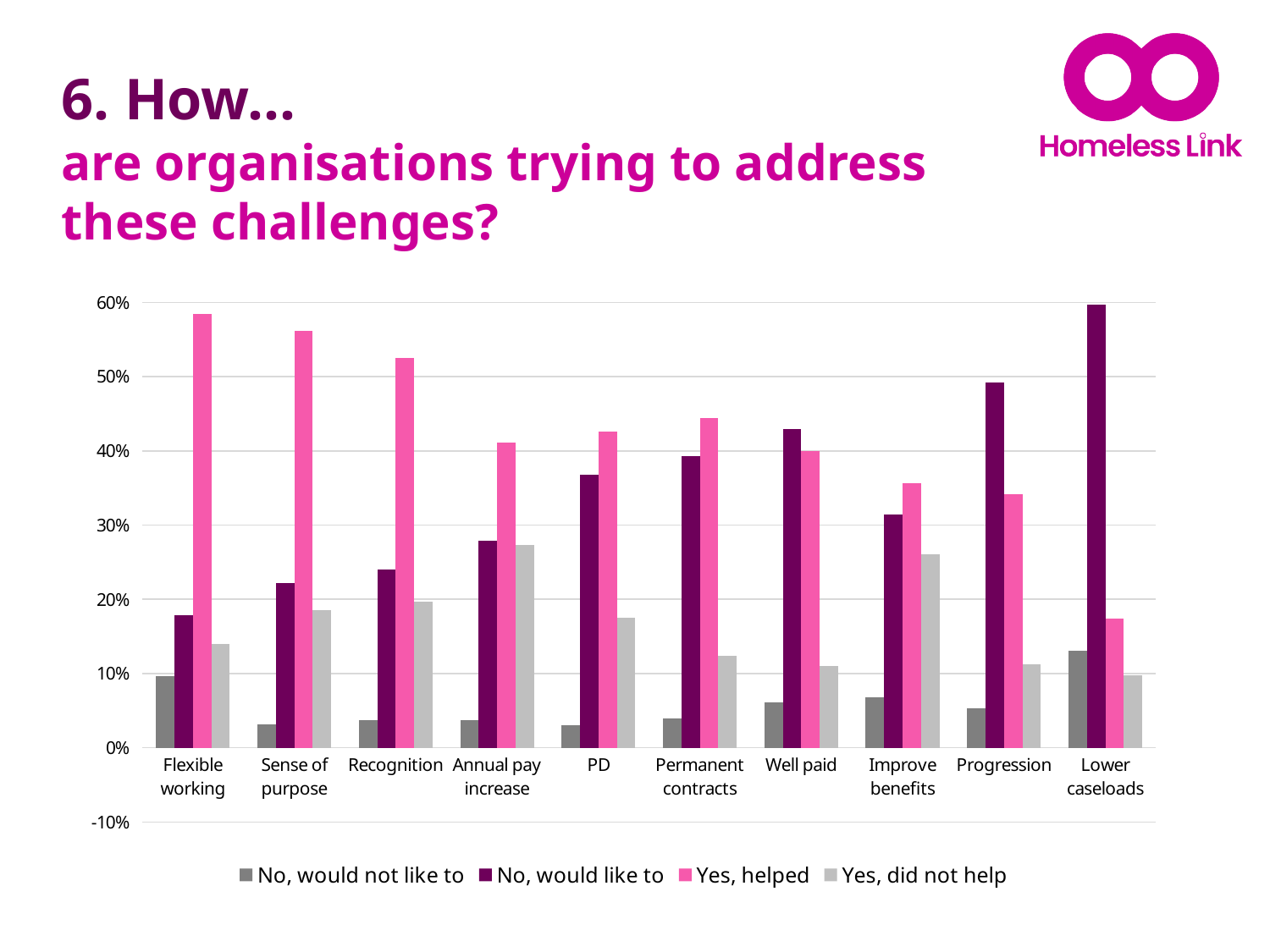
What colour represents the 'Yes, helped' series in the chart? Pink What kind of chart is shown on the slide? Bar chart For which category is the 'No, would not like to' value highest? Lower caseloads For which category is the 'No, would like to' value highest? Lower caseloads For which category is the 'Yes, helped' value lowest? Lower caseloads Is the 'Yes, helped' value for Lower caseloads greater or less than 20%? less Is the 'Yes, helped' value for Flexible working greater or less than 50%? greater Is the 'Yes, did not help' value for Annual pay increase greater or less than 20%? greater For Progression, which is larger: 'No, would like to' or 'Yes, helped'? No, would like to How many categories are shown along the x axis of the chart? 10 How many series does the chart's legend list? 4